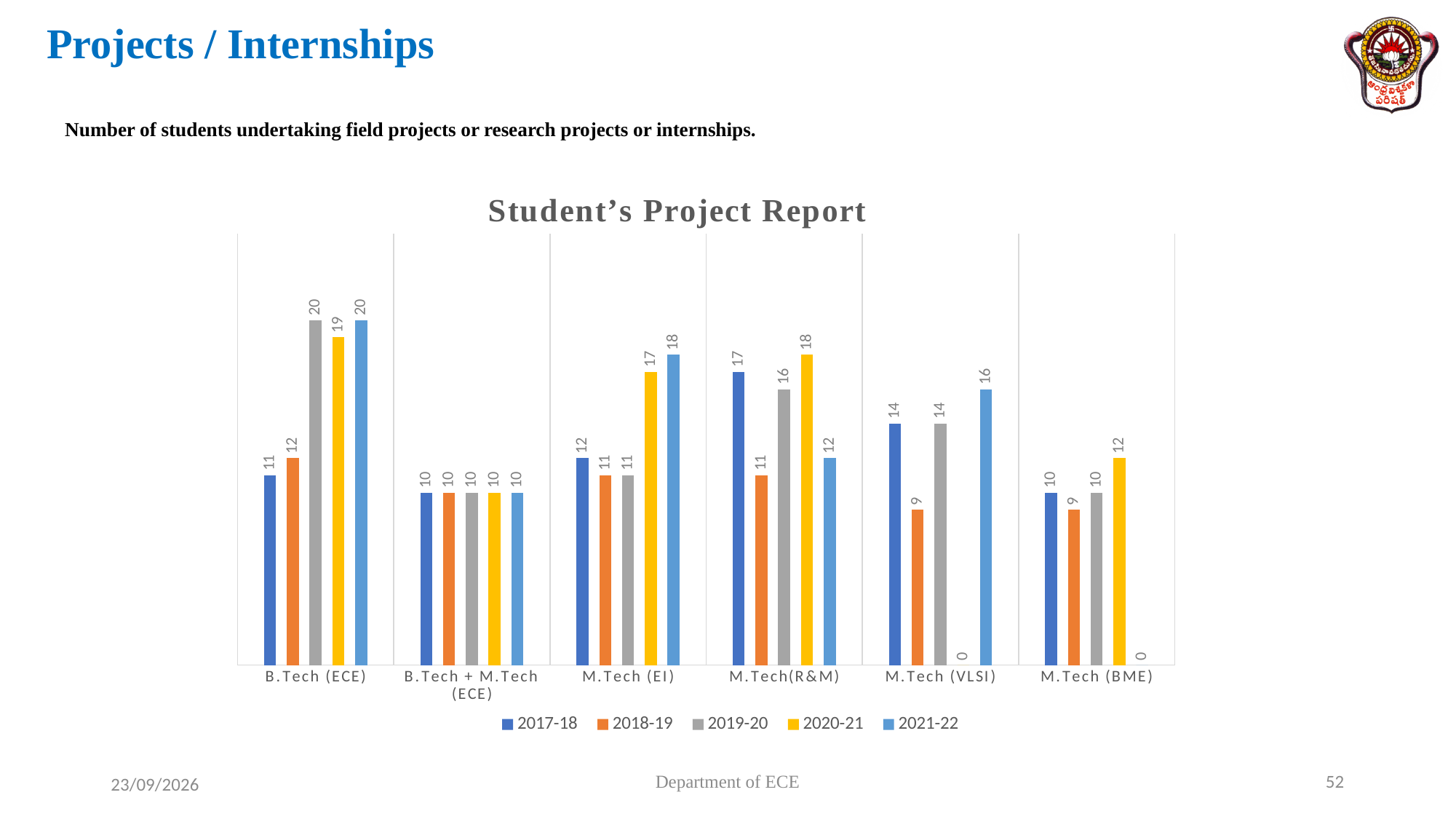
Which is larger for M.Tech (BME): the 2020-21 value or the 2019-20 value? 2020-21 Which category has the lowest value in 2021-22? M.Tech (BME) What is the value for M.Tech (VLSI) in 2020-21? 0 What is the difference between the 2021-22 and 2017-18 values for M.Tech (EI)? 6 What type of chart is shown on the slide? Bar chart How many categories are shown on the x axis? 6 How many series does the legend list? 5 What is the title of the chart? Student's Project Report Which category has the highest value in 2019-20? B.Tech (ECE) What is the value for B.Tech (ECE) in 2020-21? 19 Do the values for B.Tech + M.Tech (ECE) rise, fall, or stay the same across the years? Stay the same What is the value for M.Tech(R&M) in 2017-18? 17